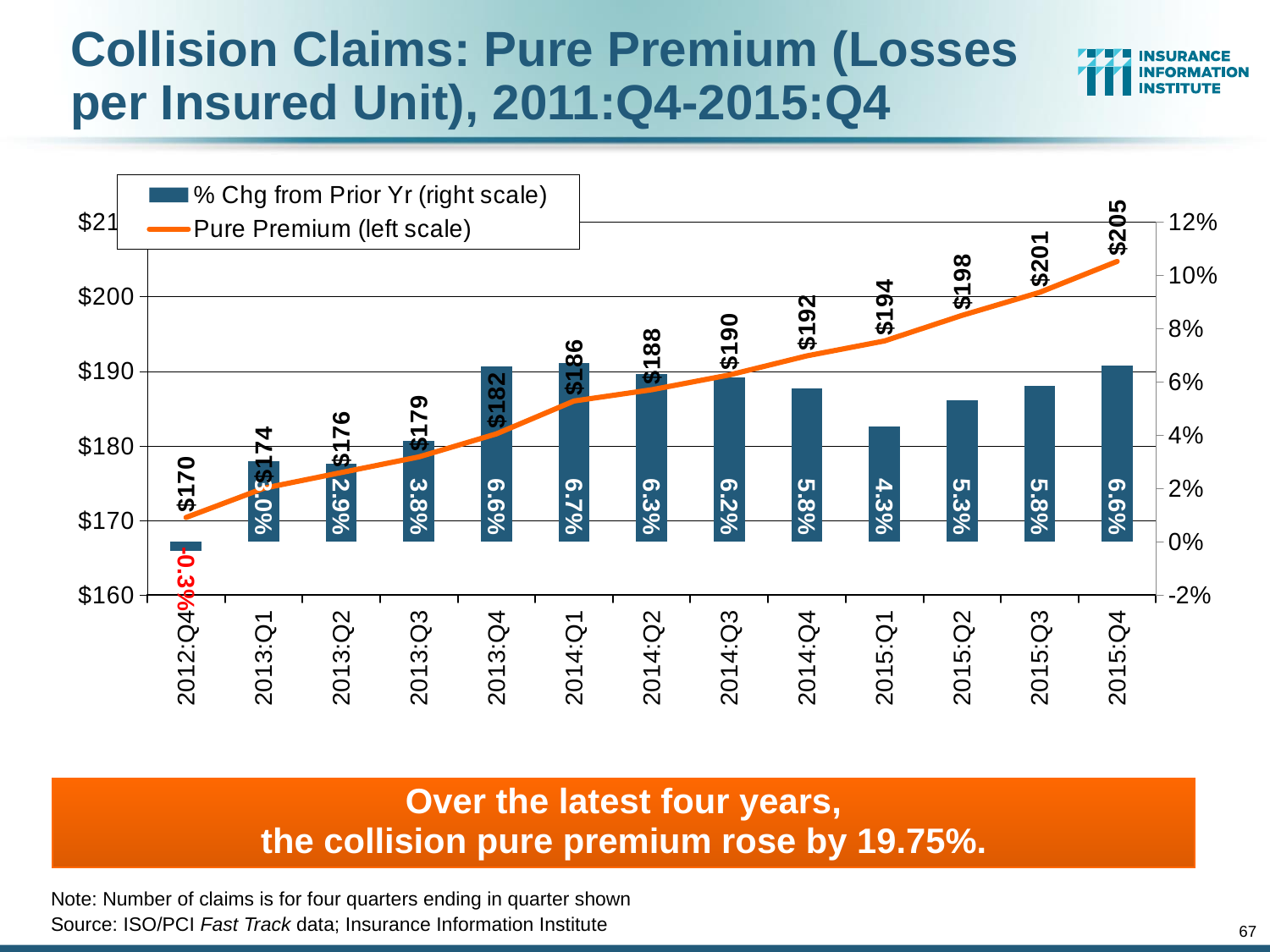
What is the difference in Pure Premium between 2015:Q4 and 2012:Q4? $35 What is the % Chg from Prior Yr for 2012:Q4? -0.3% What is the Pure Premium value for 2013:Q4? $182 Which quarter has the lowest % Chg from Prior Yr? 2012:Q4 Which series is plotted on the right scale according to the legend? % Chg from Prior Yr How many quarters are shown on the x axis? 13 Which is larger, the % Chg from Prior Yr in 2014:Q1 or in 2015:Q2? 2014:Q1 Which quarter has the highest Pure Premium? 2015:Q4 How many series does the legend list? 2 Does the Pure Premium line rise or fall from 2012:Q4 to 2015:Q4? rise What is the Pure Premium value for 2015:Q4? $205 What is the % Chg from Prior Yr for 2015:Q1? 4.3%